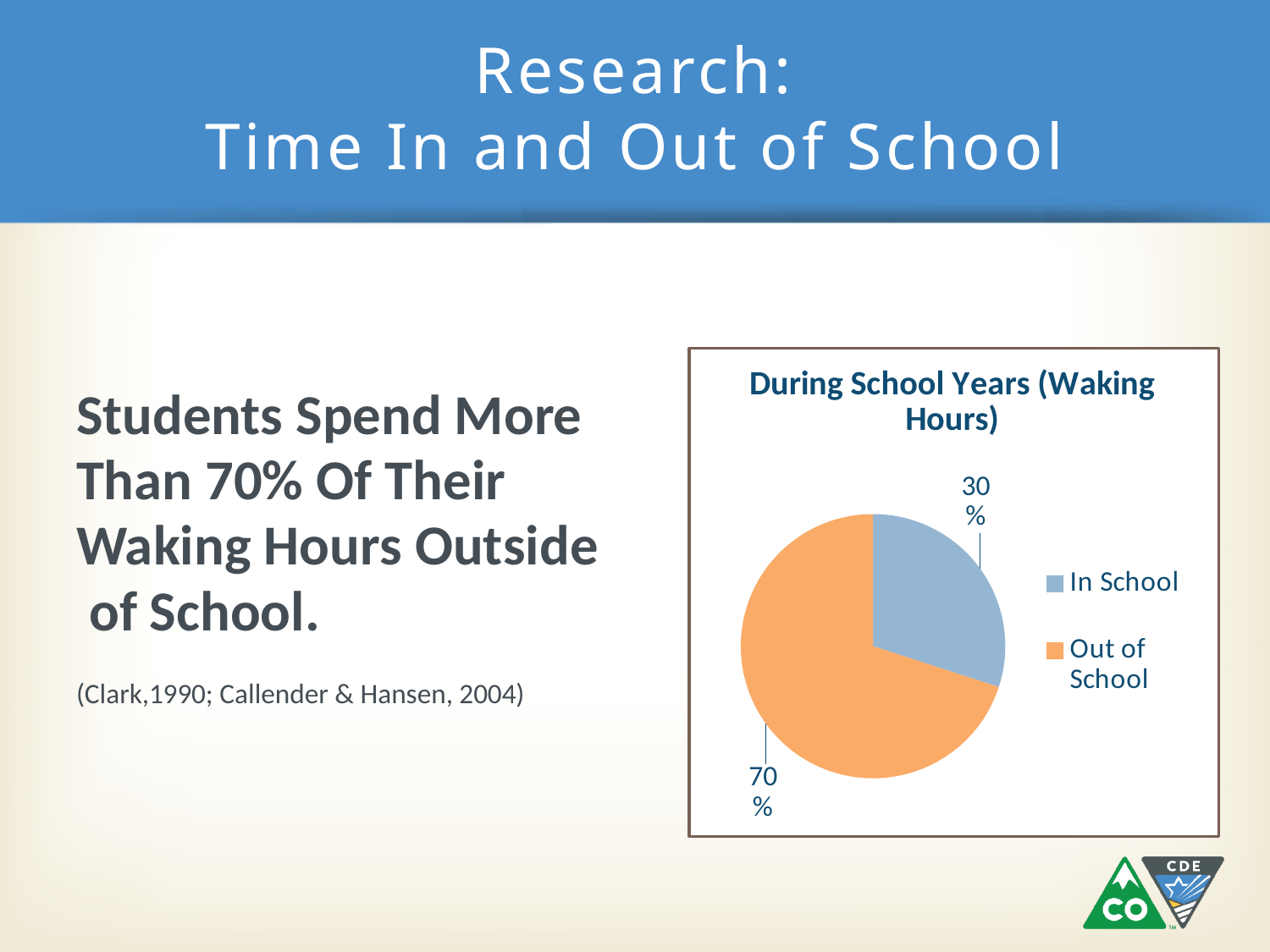
What percentage of waking hours is spent Out of School according to the chart? 70% Which is larger, the In School slice or the Out of School slice? Out of School Which slice of the pie is the largest? Out of School How many slices does the pie chart have? 2 Which slice of the pie is the smallest? In School What percentage of waking hours is spent In School according to the chart? 30% What colour is the Out of School slice? orange What share of the pie does the In School slice represent? 30% What kind of chart is shown on the slide? pie chart What is the difference in percentage points between the Out of School and In School slices? 40 What is the title of the chart? During School Years (Waking Hours) How many entries does the legend list? 2